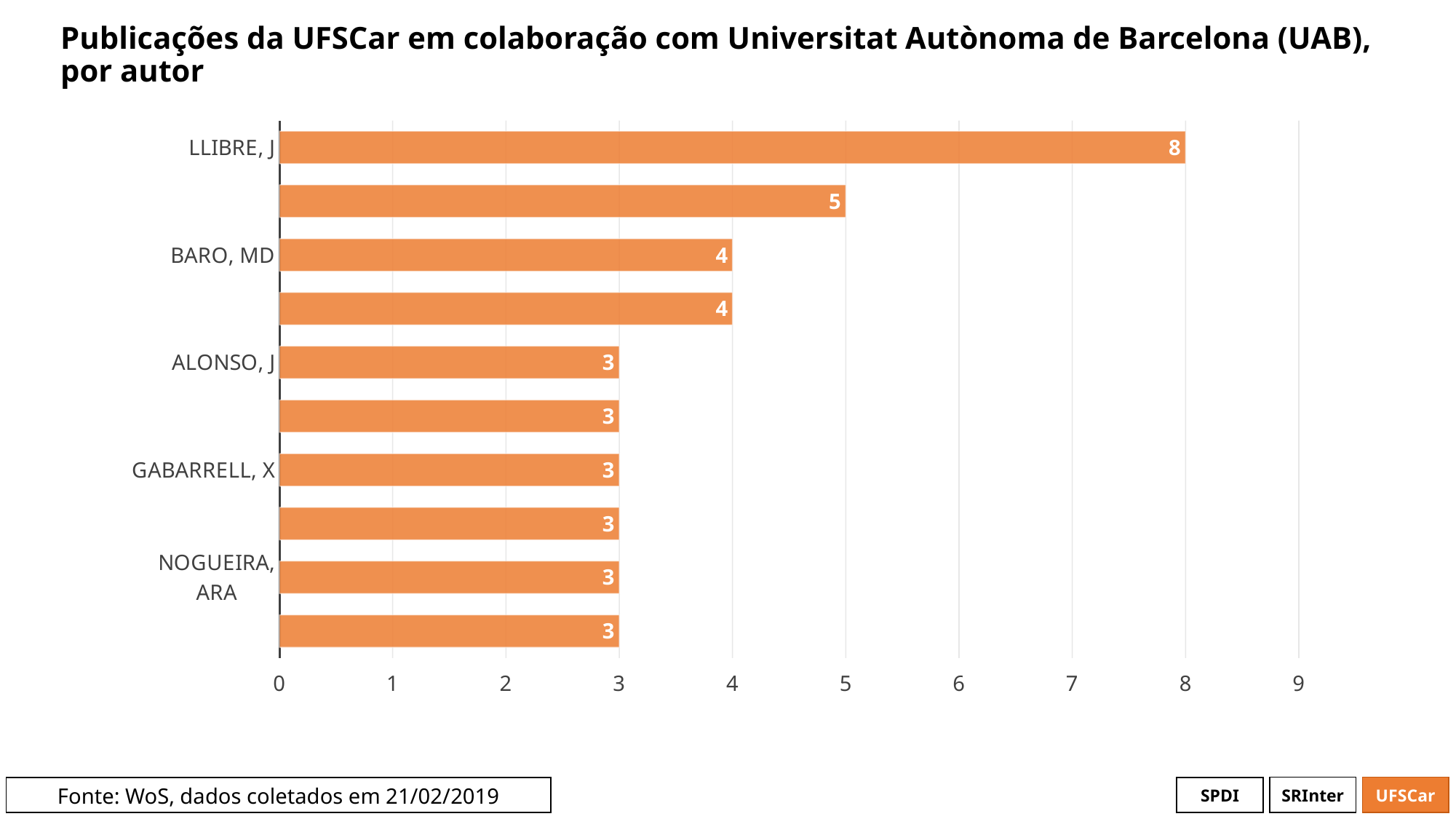
How many bars are plotted in the chart? 10 What is the value shown for BARO, MD? 4 What colour are the bars in the chart? Orange What is the value shown for GABARRELL, X? 3 What kind of chart is shown on the slide? Bar chart What is the value shown for ALONSO, J? 3 What is the difference between the values for LLIBRE, J and BARO, MD? 4 How many publications does LLIBRE, J have in the chart? 8 What is the value shown for NOGUEIRA, ARA? 3 Is the value for LLIBRE, J greater or less than 7? greater Which author has the highest number of publications in the chart? LLIBRE, J Which is larger, the value for LLIBRE, J or the value for ALONSO, J? LLIBRE, J